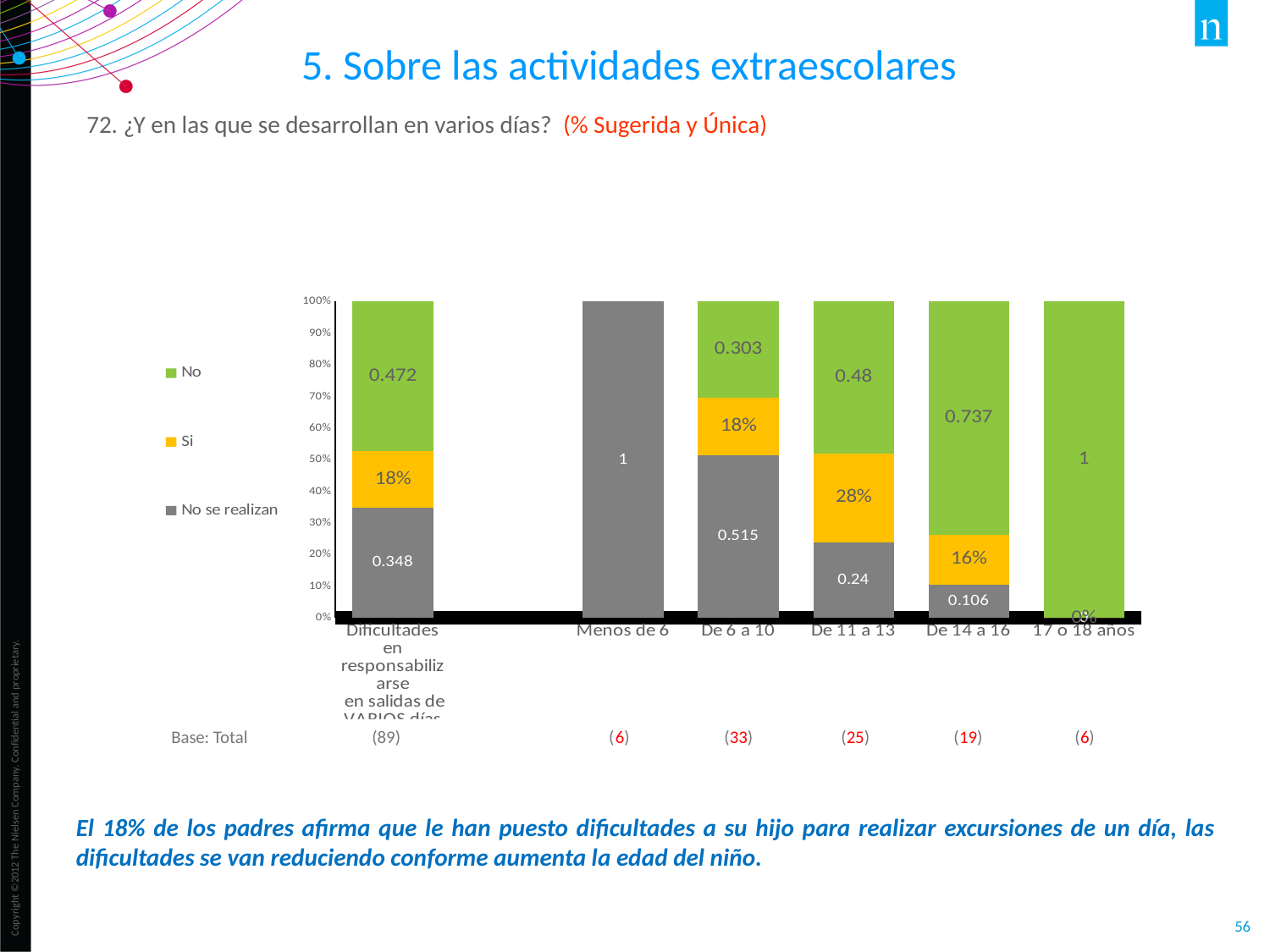
Which age category has the highest value for the 'Si' series? De 11 a 13 How many series does the legend list? 3 What kind of chart is shown on the slide? stacked bar chart Is the 'No' value for 'De 14 a 16' larger or smaller than the 'No' value for 'De 11 a 13'? larger What is the value of the 'No se realizan' series for the 'De 14 a 16' category? 0.106 What is the value of the 'Si' series for the 'De 11 a 13' category? 28% Which category has the lowest value for the 'Si' series? Menos de 6 and 17 o 18 años (both 0%) What is the difference between the 'Si' values for 'De 11 a 13' and 'De 14 a 16'? 12% What is the value of the 'No' series for the 'De 6 a 10' category? 0.303 What is the value of the 'No' series for the '17 o 18 años' category? 1 What is the value of the 'No se realizan' series for the 'Menos de 6' category? 1 Which legend entry is shown in green? No